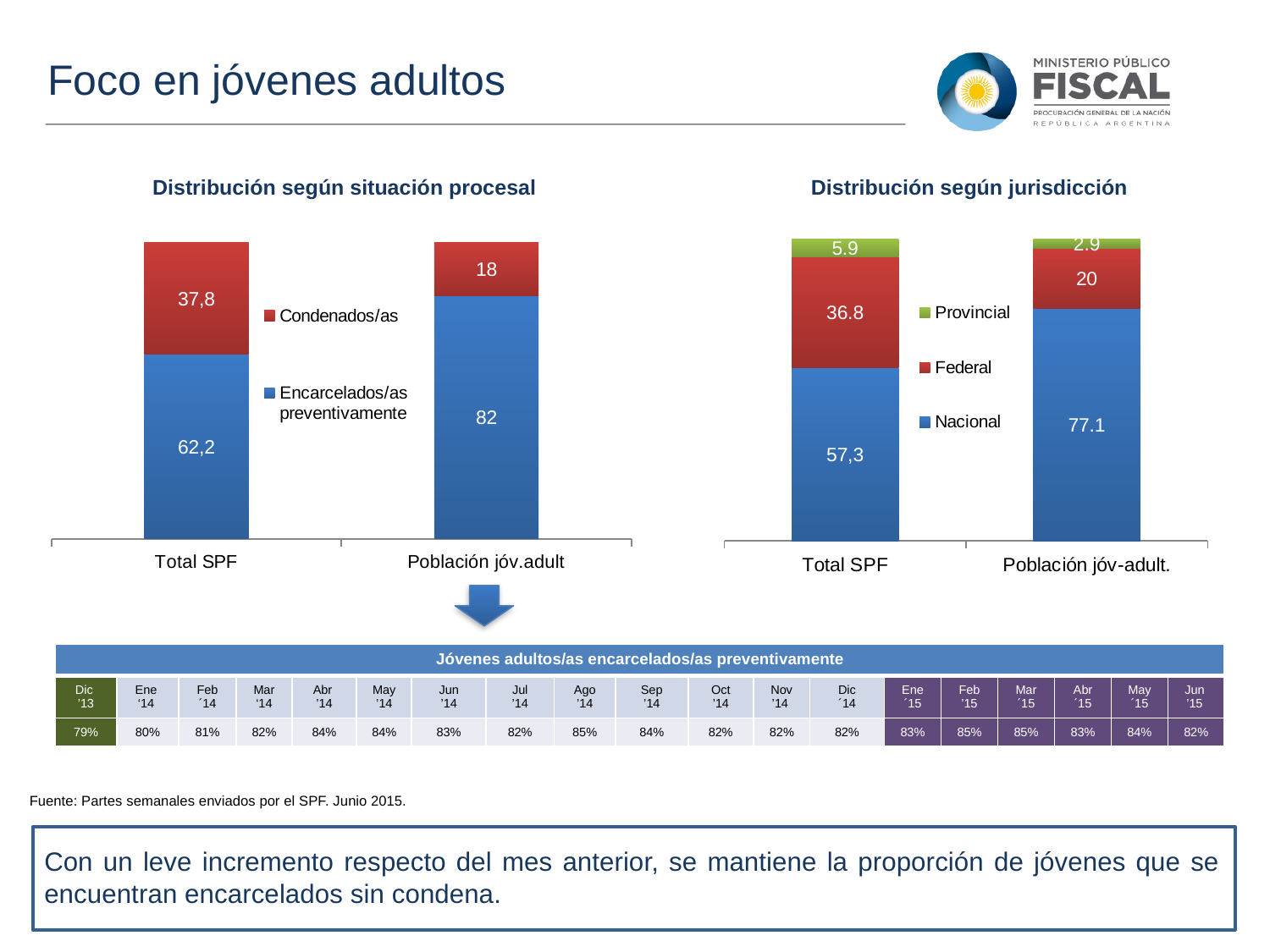
In the 'Distribución según situación procesal' chart, what is the difference between the Condenados/as values for Total SPF and Población jóv.adult? 19,8 In the 'Distribución según jurisdicción' chart, which bar has the larger Nacional value, Total SPF or Población jóv-adult.? Población jóv-adult. What kind of chart is the 'Distribución según jurisdicción' chart? Stacked bar chart In the 'Distribución según jurisdicción' chart, how many series does the legend list? 3 In the 'Distribución según situación procesal' chart, how many series does the legend list? 2 In the 'Distribución según situación procesal' chart, what is the value for Condenados/as in the Población jóv.adult bar? 18 In the 'Distribución según jurisdicción' chart, what is the value for Provincial in the Población jóv-adult. bar? 2.9 In the 'Distribución según situación procesal' chart, what is the value for Encarcelados/as preventivamente in the Total SPF bar? 62,2 In the 'Distribución según jurisdicción' chart, which series has the smallest value in the Total SPF bar? Provincial In the 'Distribución según jurisdicción' chart, what is the value for Nacional in the Población jóv-adult. bar? 77.1 In the 'Distribución según jurisdicción' chart, what is the value for Federal in the Total SPF bar? 36.8 In the 'Distribución según situación procesal' chart, what is the value for Encarcelados/as preventivamente in the Población jóv.adult bar? 82